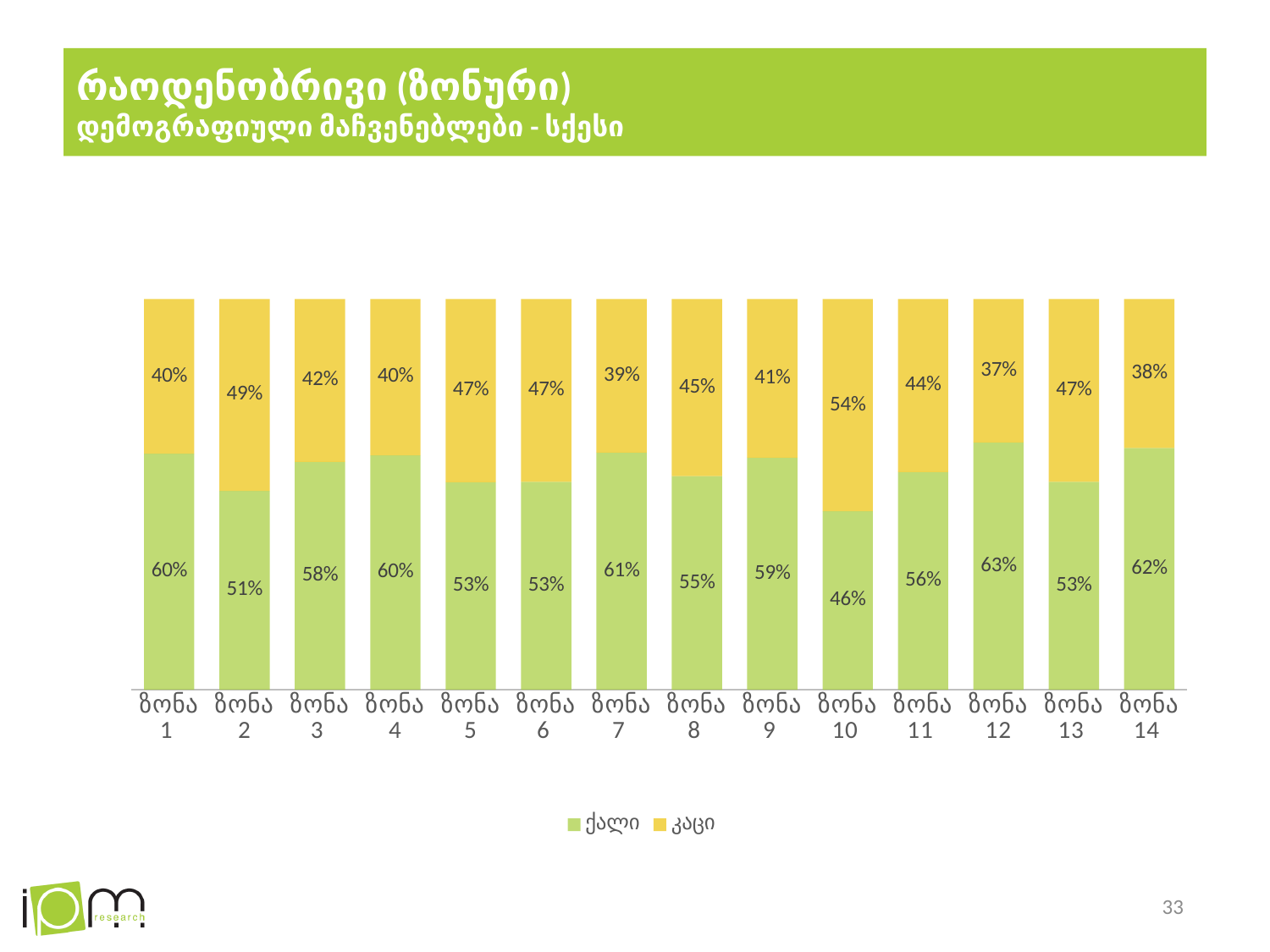
What is the value for ქალი in ზონა 12? 63% Which zone has the highest value for კაცი? ზონა 10 How many zones are shown on the x axis? 14 What is the value for კაცი in ზონა 7? 39% What is the difference between the ქალი value in ზონა 14 and the ქალი value in ზონა 2? 11% Which zone has the highest value for ქალი? ზონა 12 How many series does the legend list? 2 What is the value for კაცი in ზონა 10? 54% What kind of chart is shown on the slide? Stacked bar chart Which zone has the lowest value for ქალი? ზონა 10 What is the value for ქალი in ზონა 1? 60% Which is larger: the კაცი value in ზონა 5 or the კაცი value in ზონა 9? ზონა 5